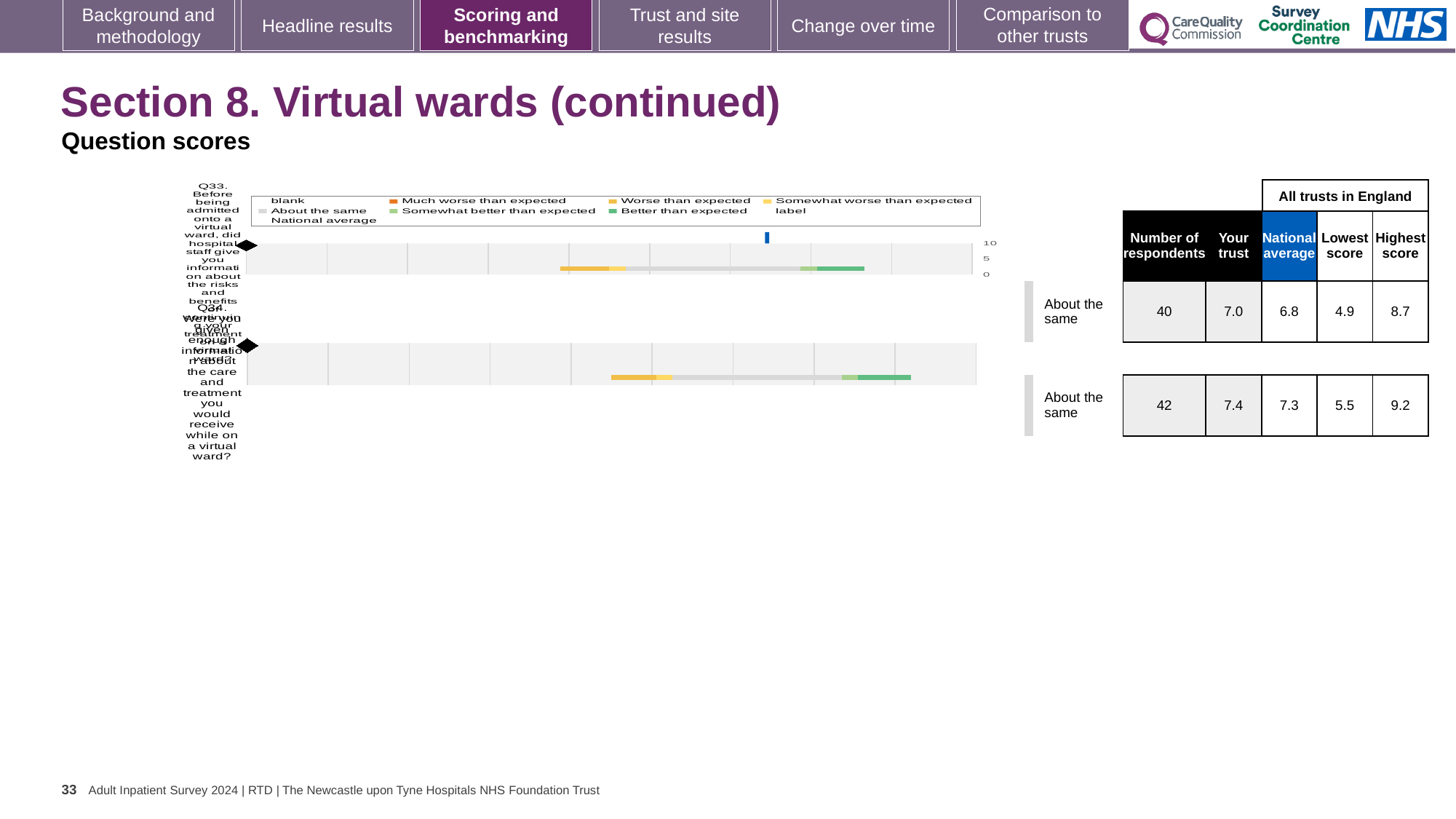
What is the national average score for Q34? 7.3 What is the 'Your trust' score for Q33? 7.0 Which question has the higher 'Your trust' score, Q33 or Q34? Q34 What is the highest score among all trusts in England for Q34? 9.2 For Q34, which is larger: the 'Your trust' score or the national average? Your trust How many respondents answered Q33? 40 What is the difference between the highest score and the lowest score for Q33? 3.8 What kind of chart is used to show the question scores on this slide? bar chart How many more respondents answered Q34 than Q33? 2 In the chart legend, what does the blue marker represent? National average What benchmark category is shown for Q33? About the same How many questions are plotted in the chart? 2